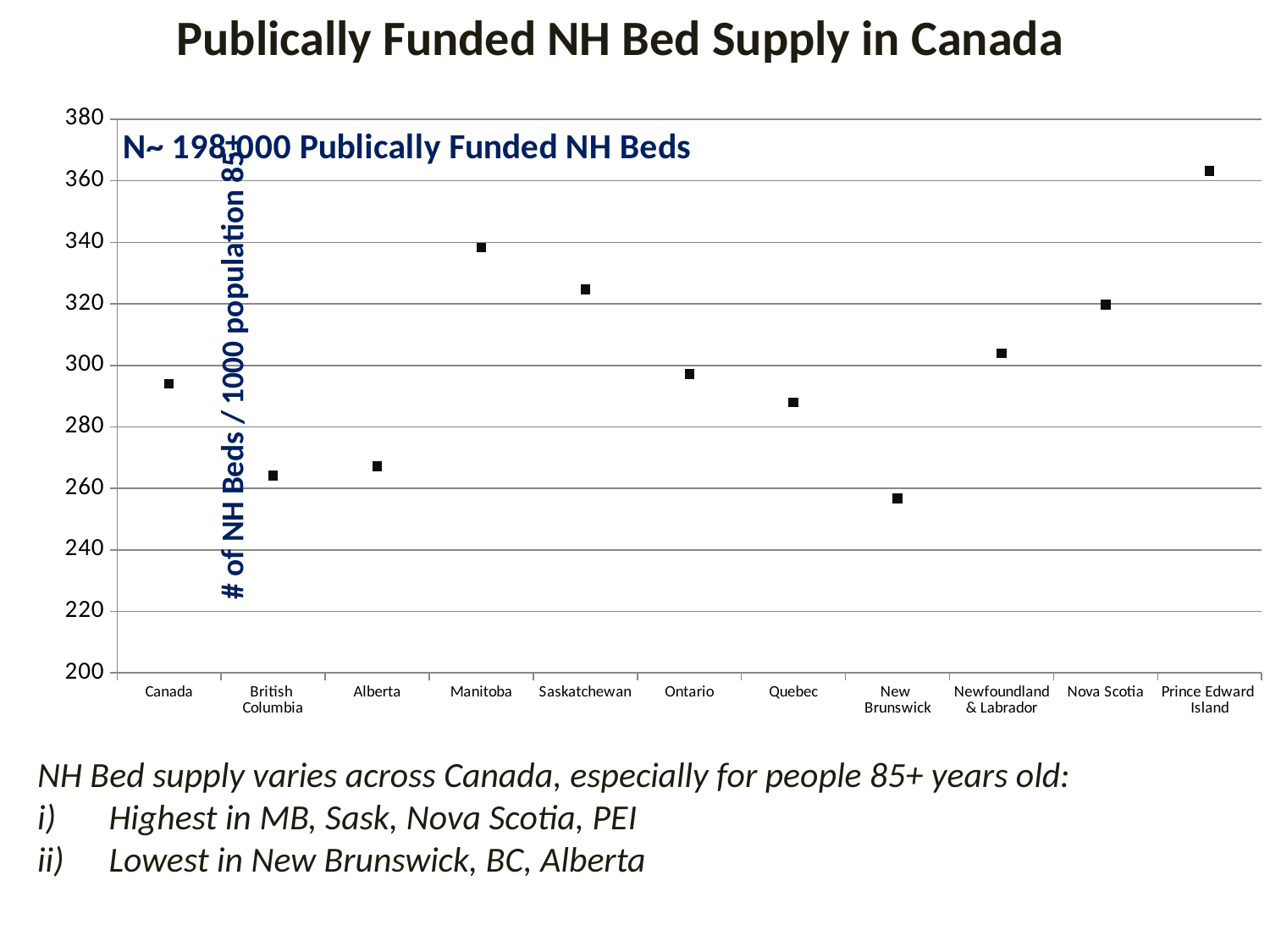
Is the value for Quebec greater or less than 300? less Which has a higher value, Manitoba or Saskatchewan? Manitoba How many categories are plotted along the x axis? 11 What is the title of the chart? Publically Funded NH Bed Supply in Canada What kind of chart is shown on the slide? scatter chart Is the value for British Columbia greater or less than 280? less Which province has the lowest number of publicly funded NH beds per 1000 population 85+? New Brunswick Which has a higher value, Nova Scotia or Newfoundland & Labrador? Nova Scotia Is the value for Nova Scotia greater or less than 300? greater Which province has the highest number of publicly funded NH beds per 1000 population 85+? Prince Edward Island